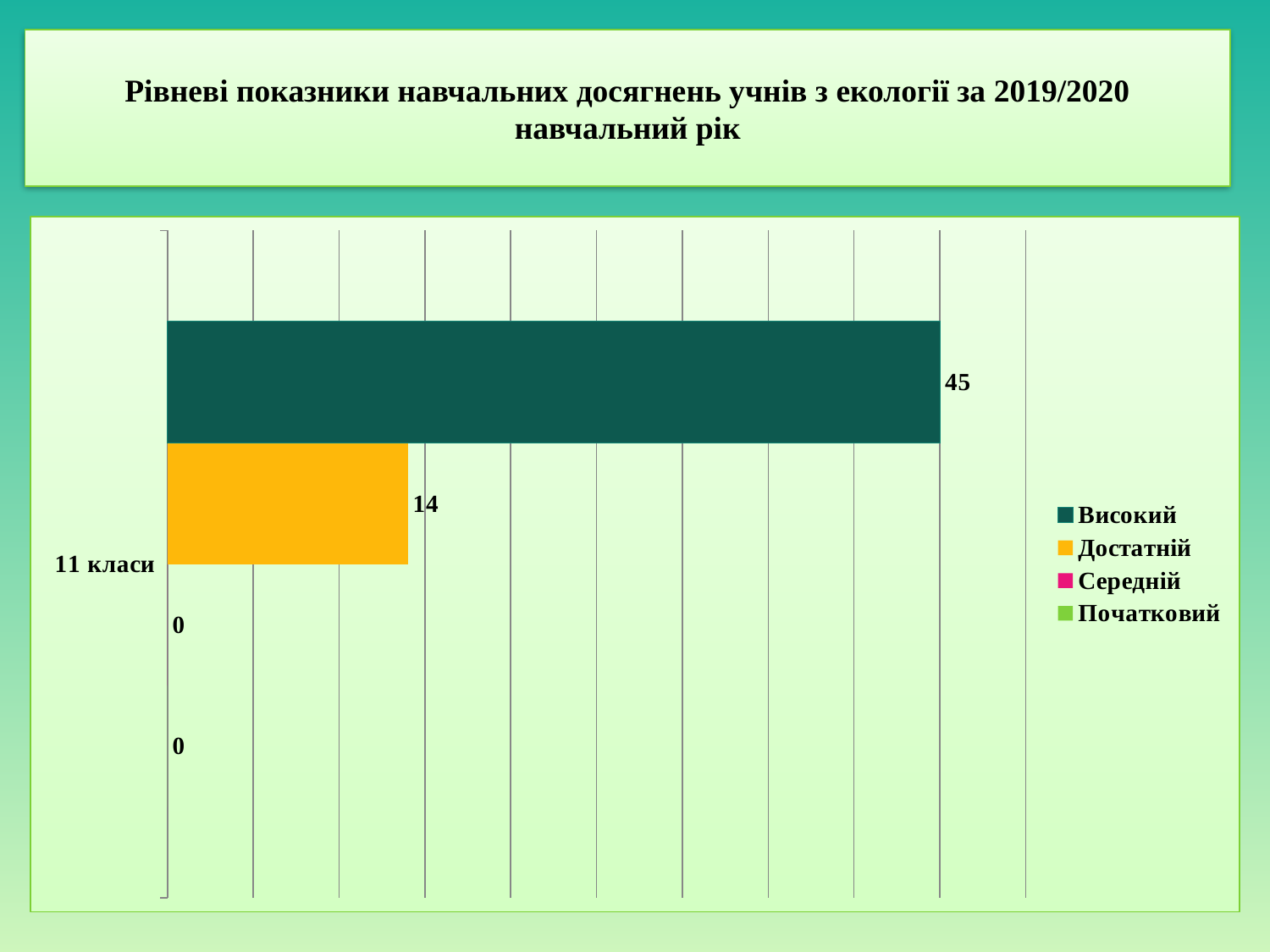
What kind of chart is shown on the slide? Bar chart What is the title of the slide? Рівневі показники навчальних досягнень учнів з екології за 2019/2020 навчальний рік How many categories are shown on the category axis? 1 Which is larger for 11 класи, the Високий value or the Достатній value? Високий What is the value for the Середній series for 11 класи? 0 What is the difference between the Високий and Достатній values for 11 класи? 31 How many series does the legend list? 4 Which series has the highest value for 11 класи? Високий What is the value for the Достатній series for 11 класи? 14 What is the value for the Високий series for 11 класи? 45 What is the value for the Початковий series for 11 класи? 0 What colour is the bar for the Достатній series? Yellow/orange